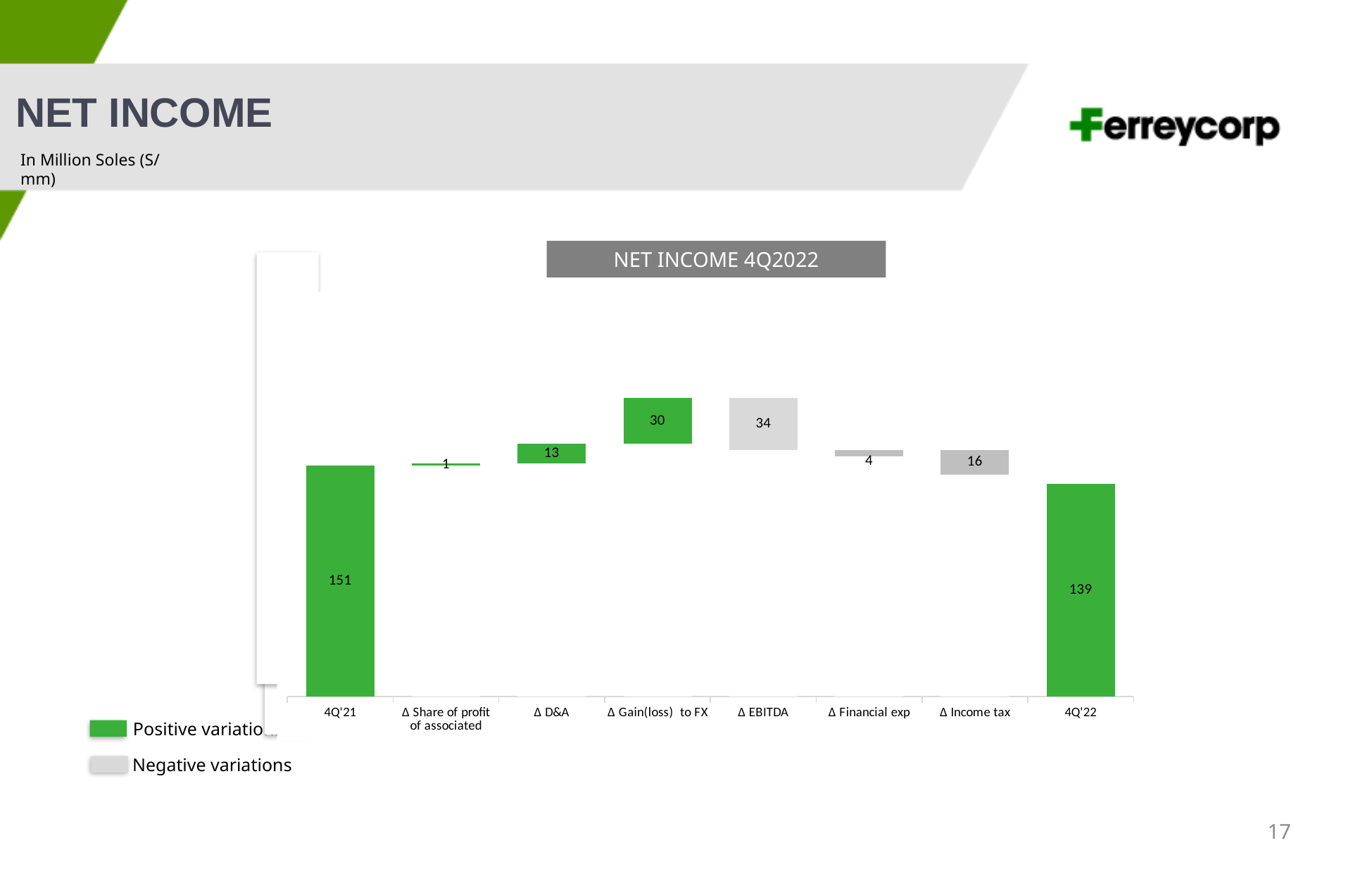
Which category has the largest labelled value? 4Q'21 What is the difference between the 4Q'21 and 4Q'22 net income values? 12 What is the value of the Δ Gain(loss) to FX bar? 30 What is the net income value shown for 4Q'22? 139 How many categories are shown on the x axis? 8 What is the value of the Δ EBITDA bar? 34 Which category has the smallest labelled value? Δ Share of profit of associated What is the net income value shown for 4Q'21? 151 What is the value of the Δ D&A bar? 13 Which is larger, the Δ EBITDA variation or the Δ Gain(loss) to FX variation? Δ EBITDA What is the value of the Δ Income tax bar? 16 What colour are the negative variations shown in, according to the legend? Grey